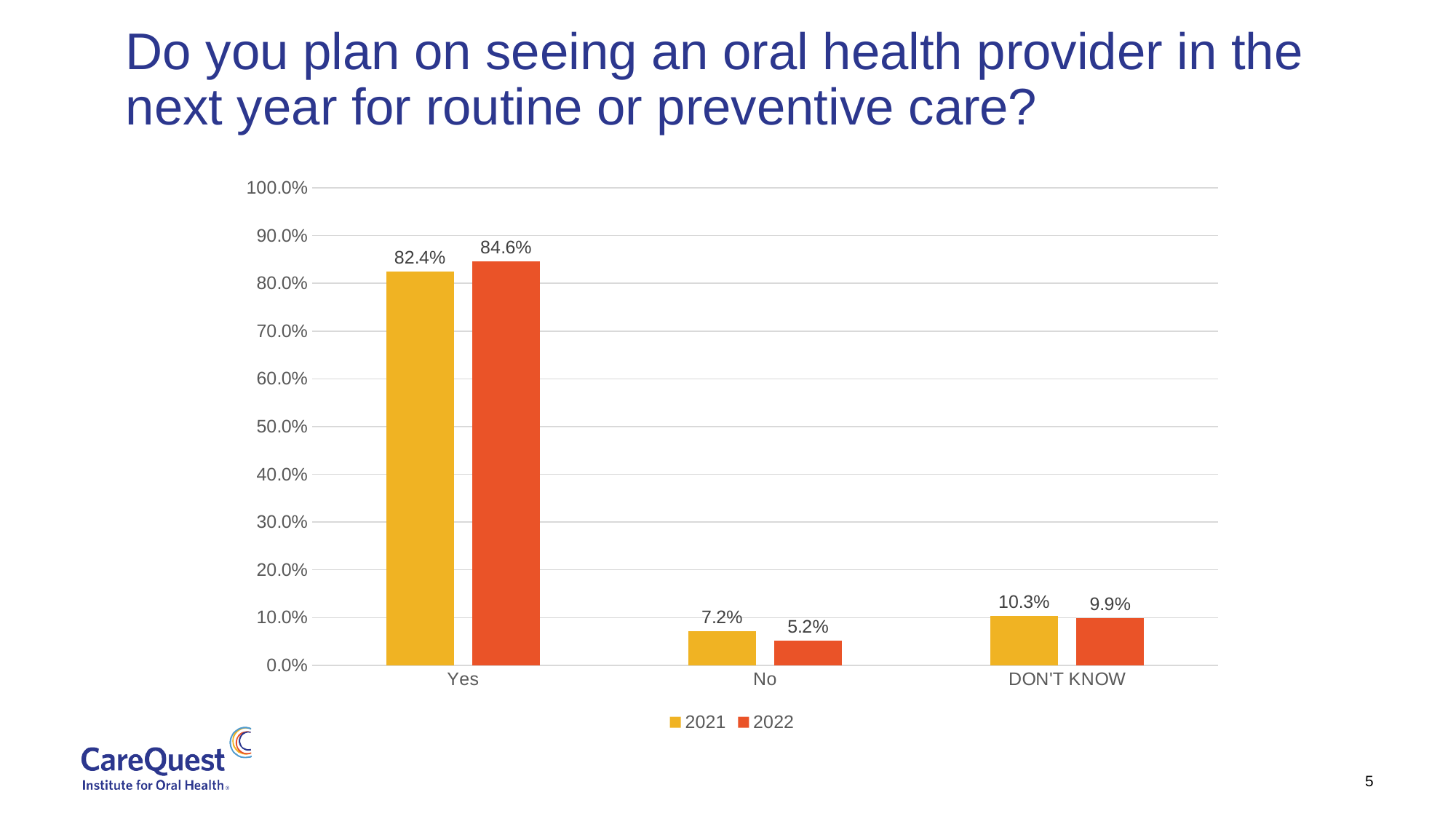
What is the difference between the 2022 and 2021 values for Yes? 2.2% How many response categories are shown on the x axis? 3 Which is larger for DON'T KNOW, the 2021 value or the 2022 value? 2021 What is the 2021 value for DON'T KNOW? 10.3% What percentage answered Yes in 2021? 82.4% What is the difference between the 2021 and 2022 values for No? 2.0% What is the 2022 value for No? 5.2% Which response category has the lowest value in 2021? No How many series does the legend list? 2 What kind of chart is shown on the slide? Bar chart What percentage answered Yes in 2022? 84.6% Which response category has the highest value in 2022? Yes